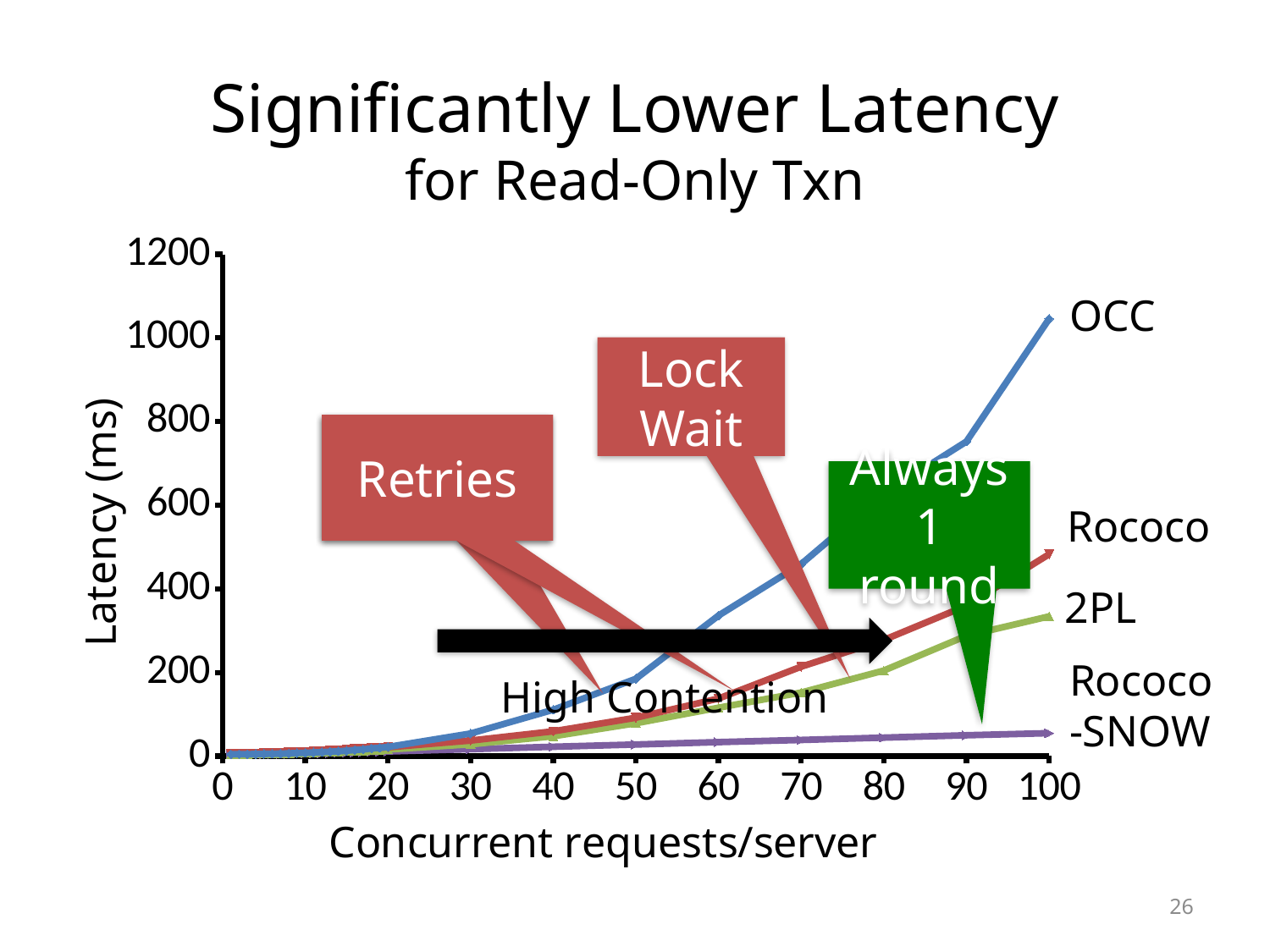
What is the label of the y axis? Latency (ms) At 100 concurrent requests/server, which has higher latency, OCC or 2PL? OCC Which series has the highest latency at 100 concurrent requests/server? OCC What kind of chart is shown on the slide? line chart Is the latency for Rococo at 100 concurrent requests/server greater or less than 600? less Which series has the lowest latency at 100 concurrent requests/server? Rococo-SNOW Is the latency for Rococo-SNOW at 100 concurrent requests/server greater or less than 200? less Is the latency for OCC at 100 concurrent requests/server greater or less than 1000? greater How many series are plotted on the chart? 4 What is the label of the x axis? Concurrent requests/server Does the latency for OCC rise or fall as concurrent requests/server increase? rise